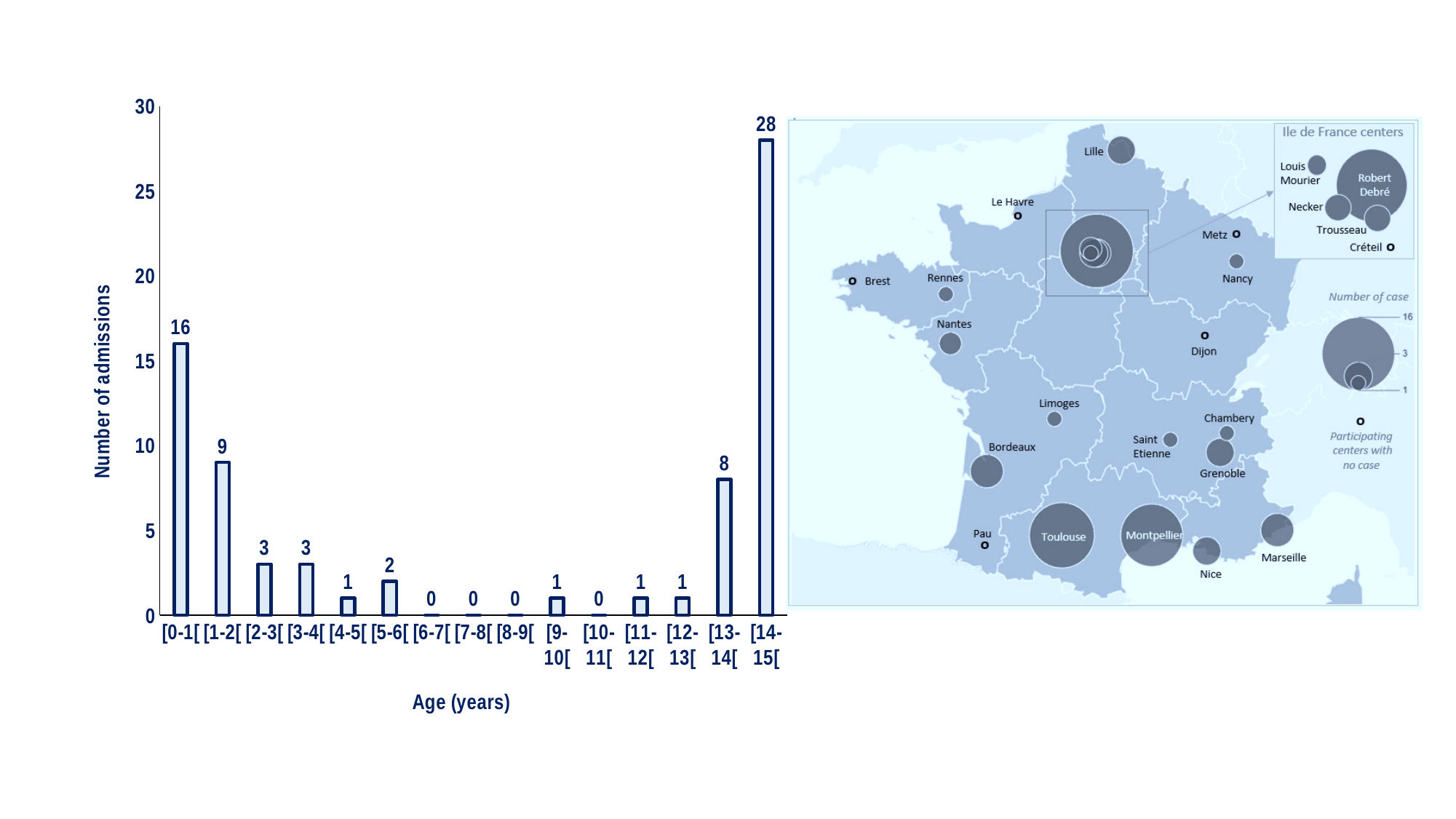
How many admissions are shown for the [13-14[ age group? 8 How many admissions are shown for the [5-6[ age group? 2 What kind of chart is used to show the number of admissions by age? bar chart What is the difference in admissions between the [14-15[ and [0-1[ age groups? 12 How many admissions are shown for the [14-15[ age group? 28 Which age group has the highest number of admissions? [14-15[ Which has more admissions, the [1-2[ age group or the [13-14[ age group? [1-2[ How many age groups are shown on the x axis of the bar chart? 15 What is the label of the y axis of the bar chart? Number of admissions How many admissions are shown for the [0-1[ age group? 16 What is the label of the x axis of the bar chart? Age (years) How many age groups have 0 admissions? 4